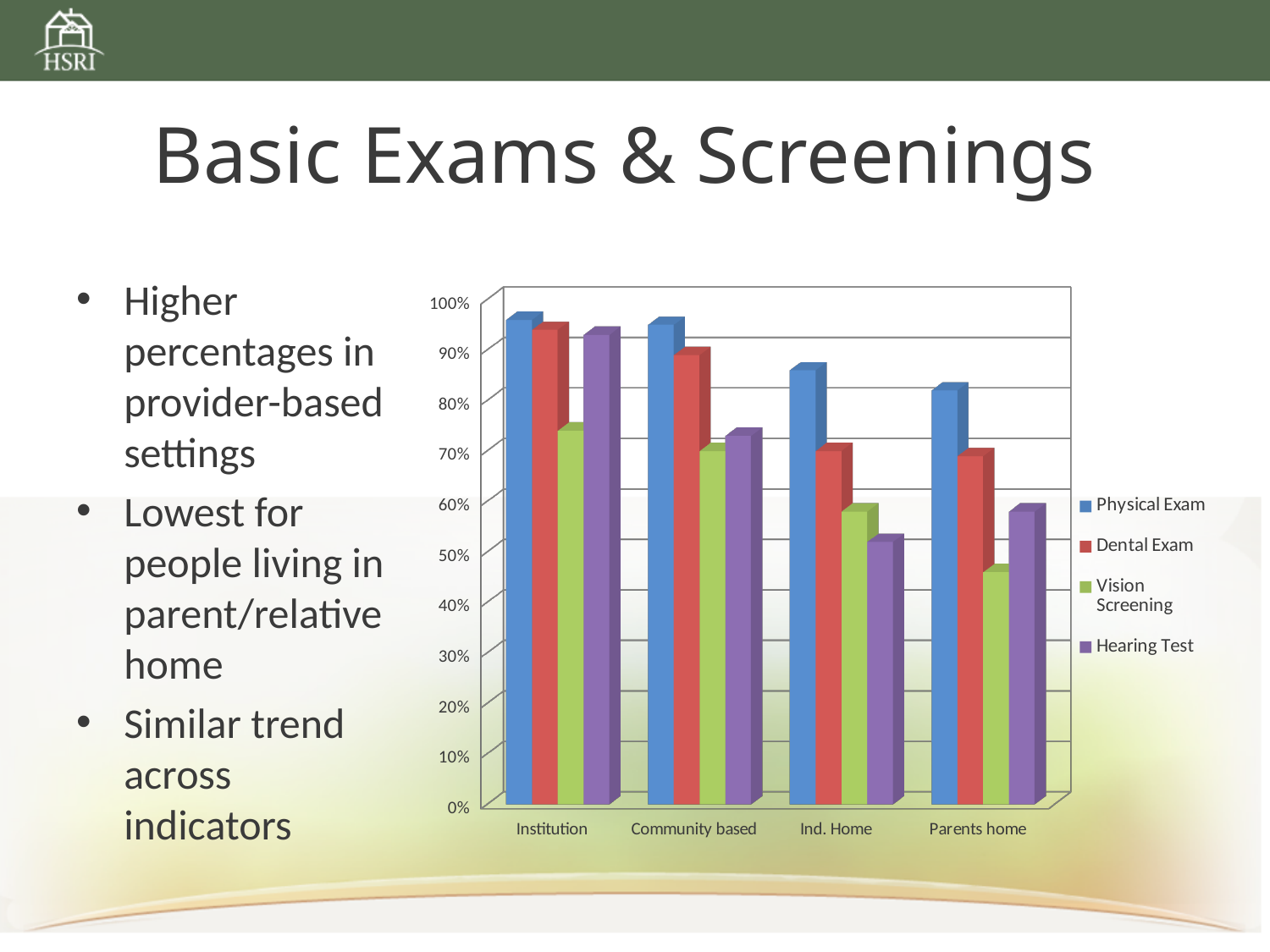
Which category has the lowest Vision Screening value? Parents home Do the Physical Exam values rise or fall moving from Institution to Parents home along the x axis? fall Is the Dental Exam value for Community based greater or less than 80%? greater How many series does the chart legend list? 4 For Institution, which is larger: Vision Screening or Hearing Test? Hearing Test Which series is shown in green in the chart? Vision Screening Is the Physical Exam value for Institution greater or less than 90%? greater How many categories are shown on the x axis of the chart? 4 Is the Hearing Test value for Ind. Home greater or less than 60%? less What kind of chart is shown on the slide? bar chart